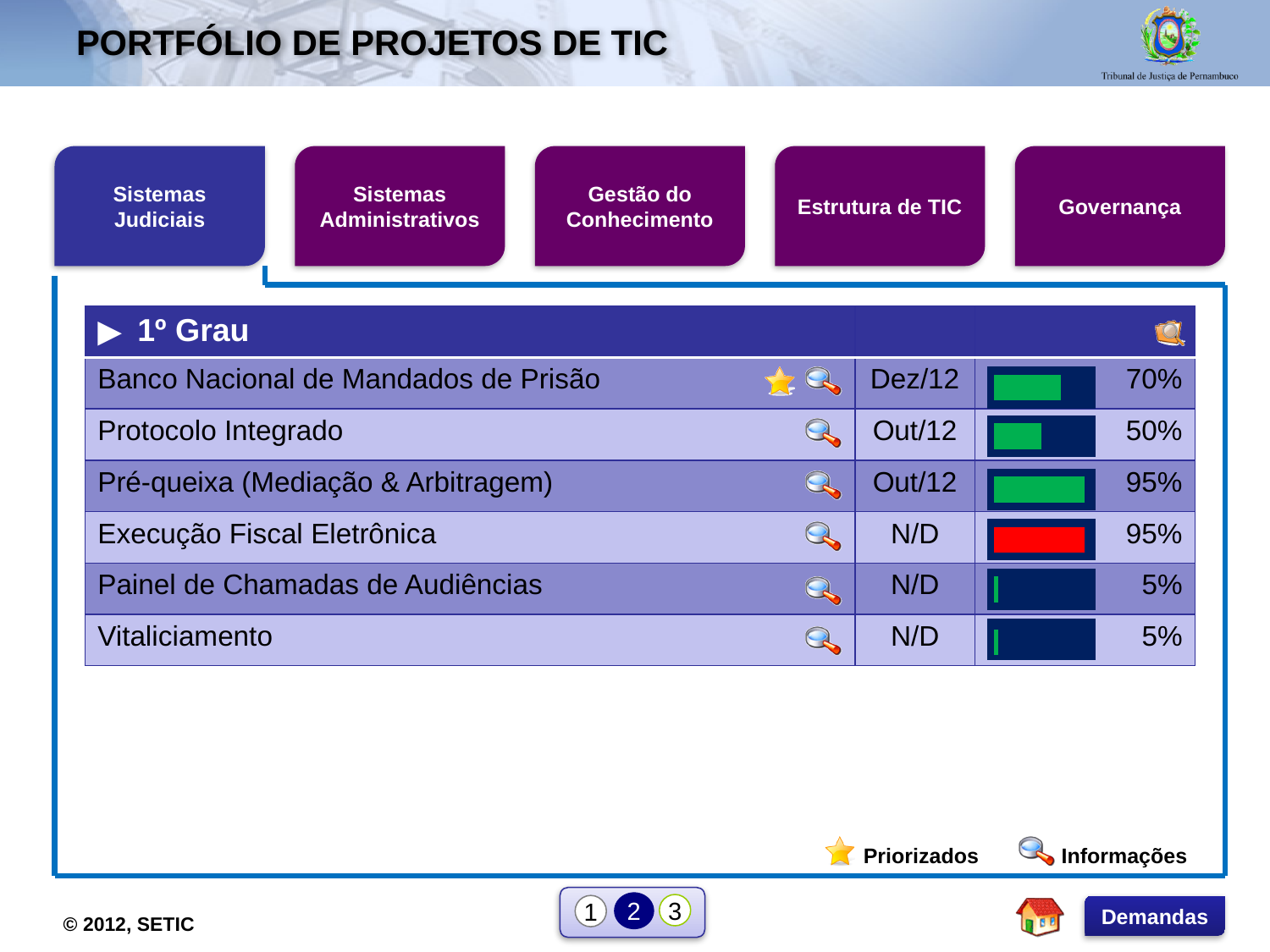
Which project's progress bar is shown in red? Execução Fiscal Eletrônica What is the difference in completion percentage between Banco Nacional de Mandados de Prisão and Protocolo Integrado? 20 percentage points What date is shown for Banco Nacional de Mandados de Prisão? Dez/12 What kind of visual is used to show each project's completion percentage? Horizontal bar (progress bar) How many projects are listed under 1º Grau? 6 What is the highest completion percentage shown in the 1º Grau table? 95% What is the completion percentage shown for Protocolo Integrado? 50% What is the completion percentage shown for Banco Nacional de Mandados de Prisão? 70% What is the completion percentage shown for Painel de Chamadas de Audiências? 5% What is the completion percentage shown for Pré-queixa (Mediação & Arbitragem)? 95% What is the lowest completion percentage shown in the 1º Grau table? 5% Which has a higher completion percentage, Banco Nacional de Mandados de Prisão or Protocolo Integrado? Banco Nacional de Mandados de Prisão